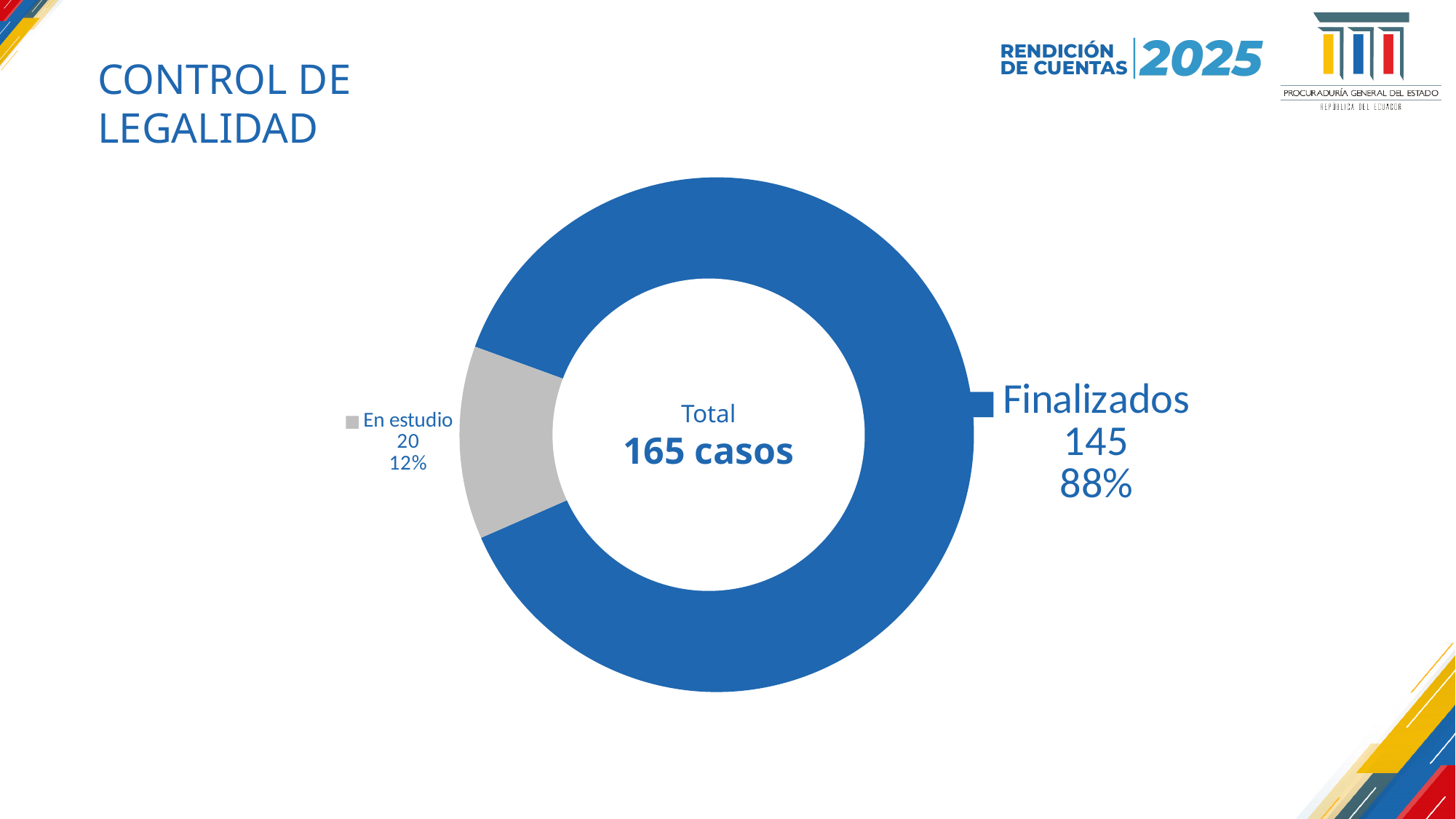
What colour is the Finalizados segment of the chart? Blue What percentage of cases are En estudio? 12% Which category has the largest share of the chart? Finalizados Which category has the smallest share of the chart? En estudio What is the difference between the number of Finalizados cases and En estudio cases? 125 Which is larger, the number of Finalizados cases or En estudio cases? Finalizados How many cases are labelled as Finalizados? 145 How many categories does the chart show? 2 What is the total number of cases shown in the centre of the chart? 165 casos What percentage of cases are Finalizados? 88% How many cases are labelled as En estudio? 20 What kind of chart is shown on the slide? Doughnut chart